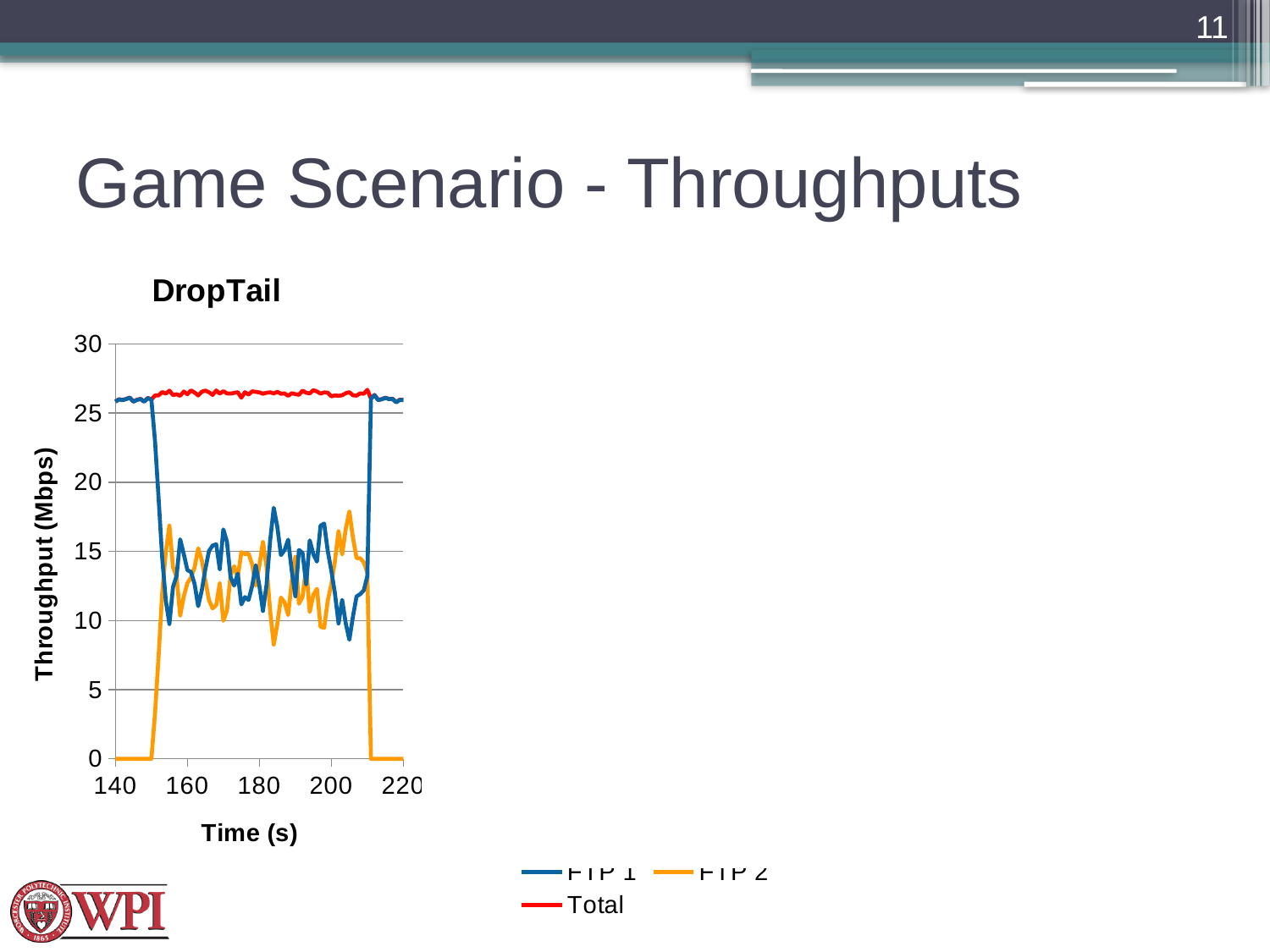
Is the value for FTP 1 at 140 s greater or less than 20? greater Does the FTP 2 line rise or fall between 140 s and 160 s? rise At 140 s, which is larger, FTP 1 or FTP 2? FTP 1 How many series does the legend list? 3 What is the label of the y axis? Throughput (Mbps) Is the value for FTP 1 at 220 s greater or less than 20? greater Does the FTP 1 line rise or fall between 140 s and 160 s? fall What is the title of the chart? DropTail What kind of chart is shown on the slide? line chart What is the value for FTP 2 at 140 s? 0 Is the value for FTP 2 at 180 s greater or less than 20? less